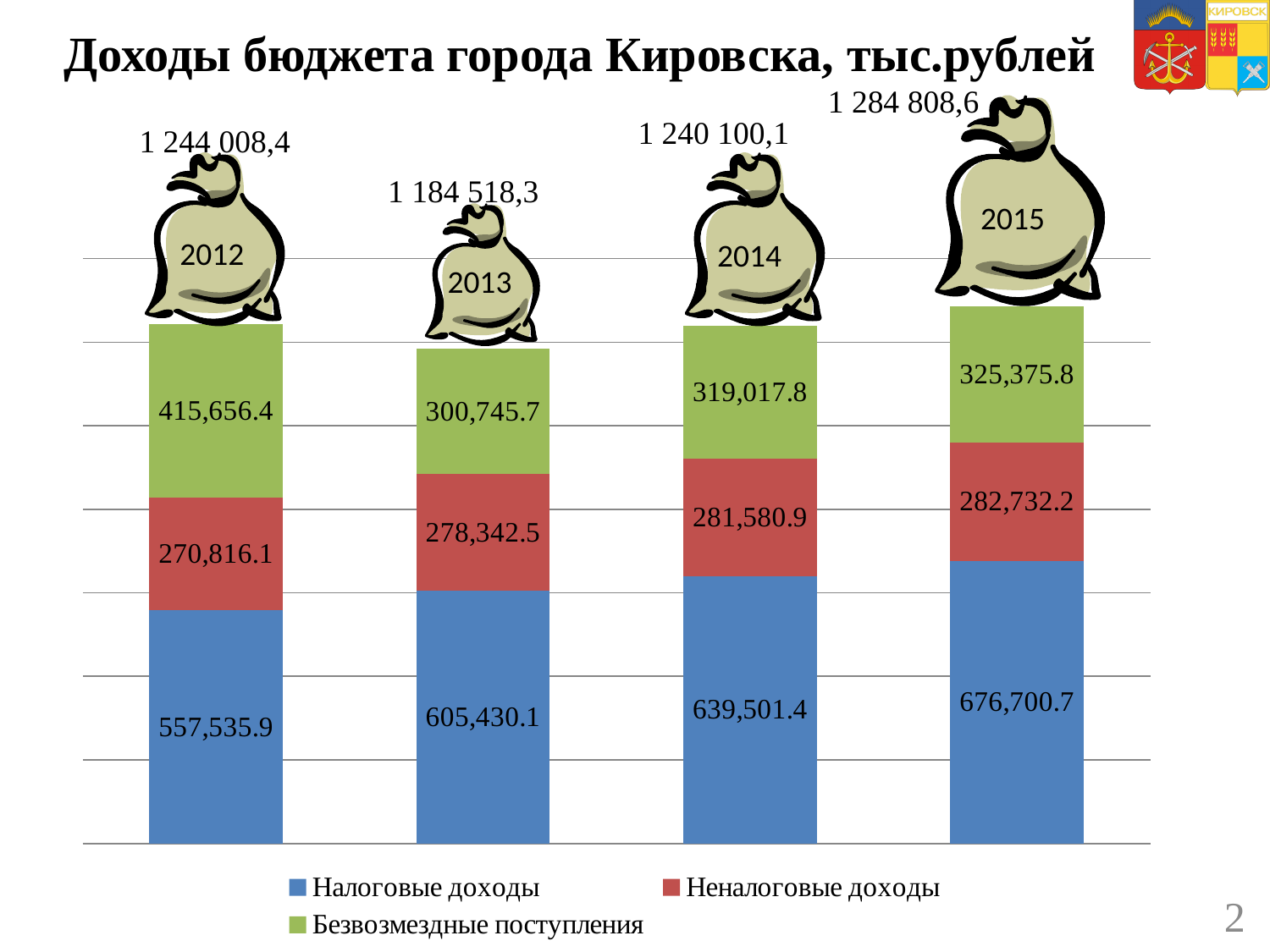
What is the total budget income shown for 2013? 1 184 518,3 What is the value of Безвозмездные поступления for 2015? 325,375.8 Which year has the highest value for Налоговые доходы? 2015 Do the values for Налоговые доходы rise or fall from 2012 to 2015? Rise What is the value of Налоговые доходы for 2012? 557,535.9 Which year has the lowest value for Безвозмездные поступления? 2013 How many years are shown on the chart? 4 How many series does the legend list? 3 Which is larger: Безвозмездные поступления in 2012 or in 2013? 2012 What kind of chart is shown on the slide? Stacked bar chart What is the difference between Налоговые доходы in 2015 and in 2012? 119,164.8 What is the value of Неналоговые доходы for 2013? 278,342.5